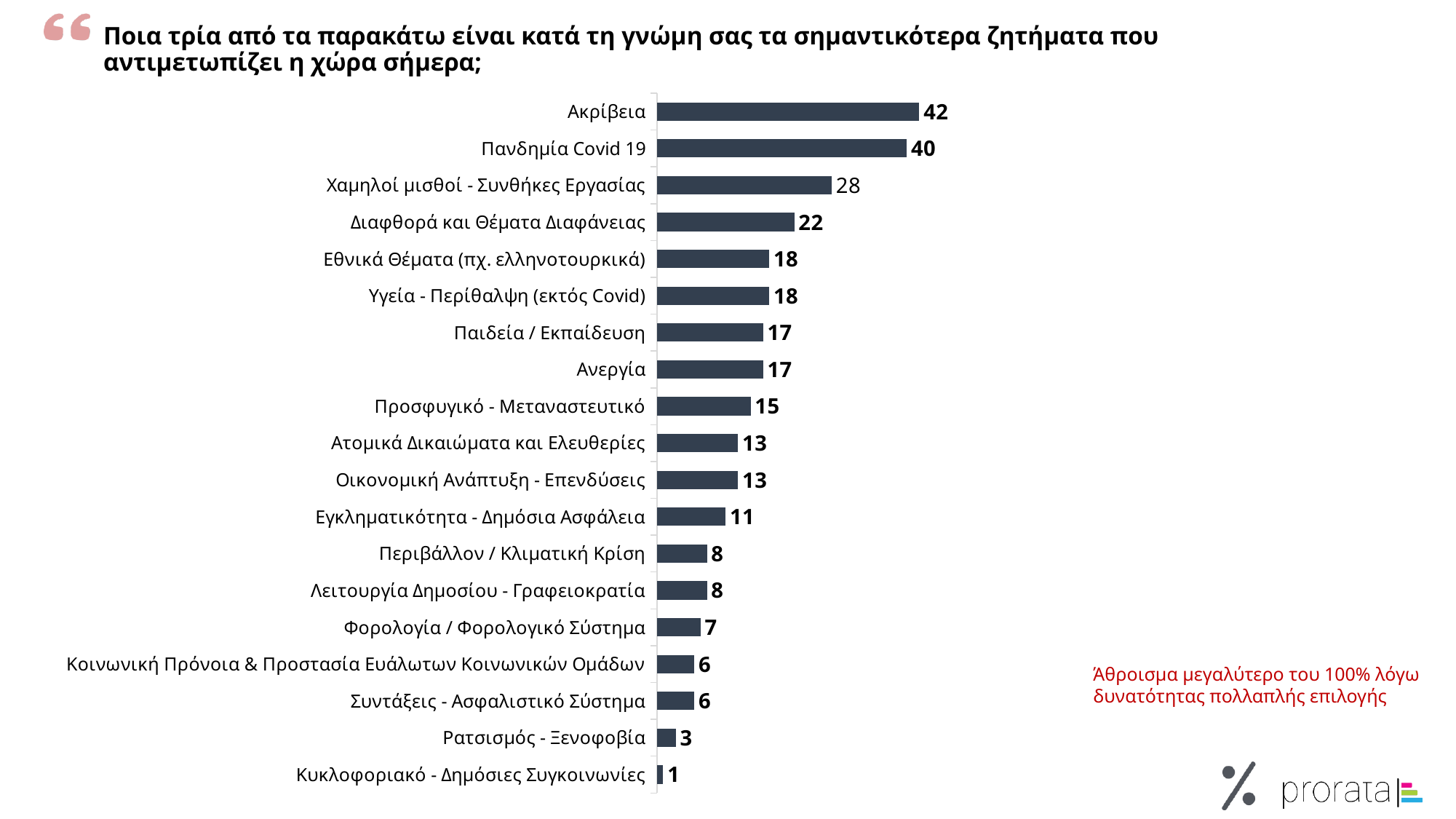
What is the difference between the values for Πανδημία Covid 19 and Ανεργία? 23 Which is larger, the value for Εγκληματικότητα - Δημόσια Ασφάλεια or the value for Φορολογία / Φορολογικό Σύστημα? Εγκληματικότητα - Δημόσια Ασφάλεια What value is shown for Χαμηλοί μισθοί - Συνθήκες Εργασίας? 28 Which category has the lowest value? Κυκλοφοριακό - Δημόσιες Συγκοινωνίες What value is shown for Πανδημία Covid 19? 40 What value is shown for Ακρίβεια? 42 Which category has the highest value? Ακρίβεια What is the difference between the values for Ακρίβεια and Διαφθορά και Θέματα Διαφάνειας? 20 How many categories are shown in the chart? 19 What value is shown for Ρατσισμός - Ξενοφοβία? 3 What value is shown for Προσφυγικό - Μεταναστευτικό? 15 What kind of chart is shown on the slide? Bar chart